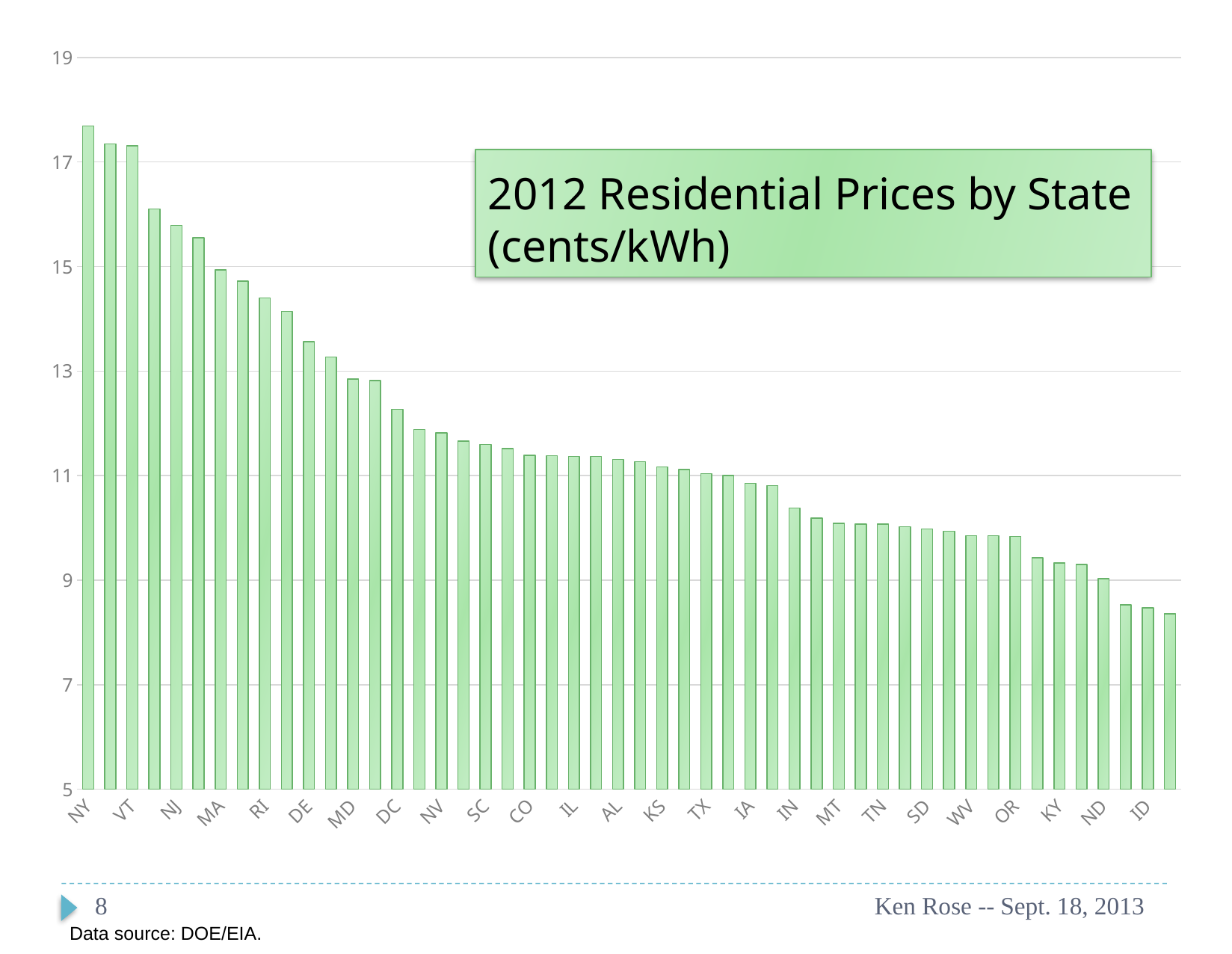
Do the values rise or fall moving from left to right along the x axis? fall Is the value for ID greater or less than 9? less What is the title of the chart? 2012 Residential Prices by State (cents/kWh) Is the value for NJ greater or less than 15? greater What kind of chart is shown on the slide? bar chart Is the value for IA greater or less than 11? less Which state has the highest 2012 residential price? NY What colour are the bars in the chart? green Which has the larger value, NJ or RI? NJ